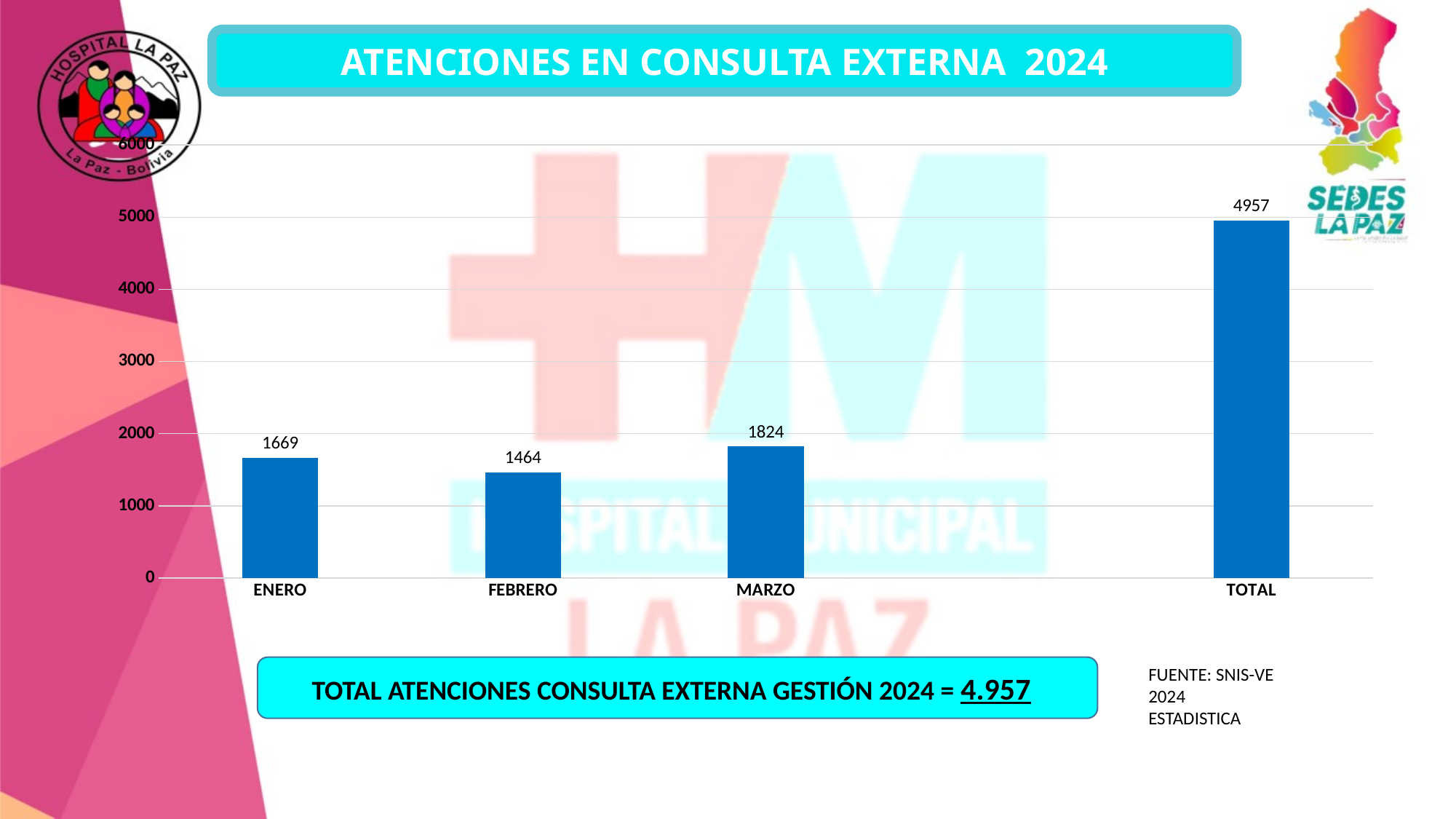
What is the value for TOTAL? 4957 What is the difference between the values for MARZO and FEBRERO? 360 What is the value for ENERO? 1669 What is the value for FEBRERO? 1464 Which is larger, the value for ENERO or the value for MARZO? MARZO What kind of chart is shown on the slide? bar chart How many bars are shown in the chart? 4 Is the value for TOTAL greater or less than 4000? greater What is the value for MARZO? 1824 What is the difference between the values for ENERO and FEBRERO? 205 Among the months ENERO, FEBRERO and MARZO, which has the lowest value? FEBRERO Among the months ENERO, FEBRERO and MARZO, which has the highest value? MARZO